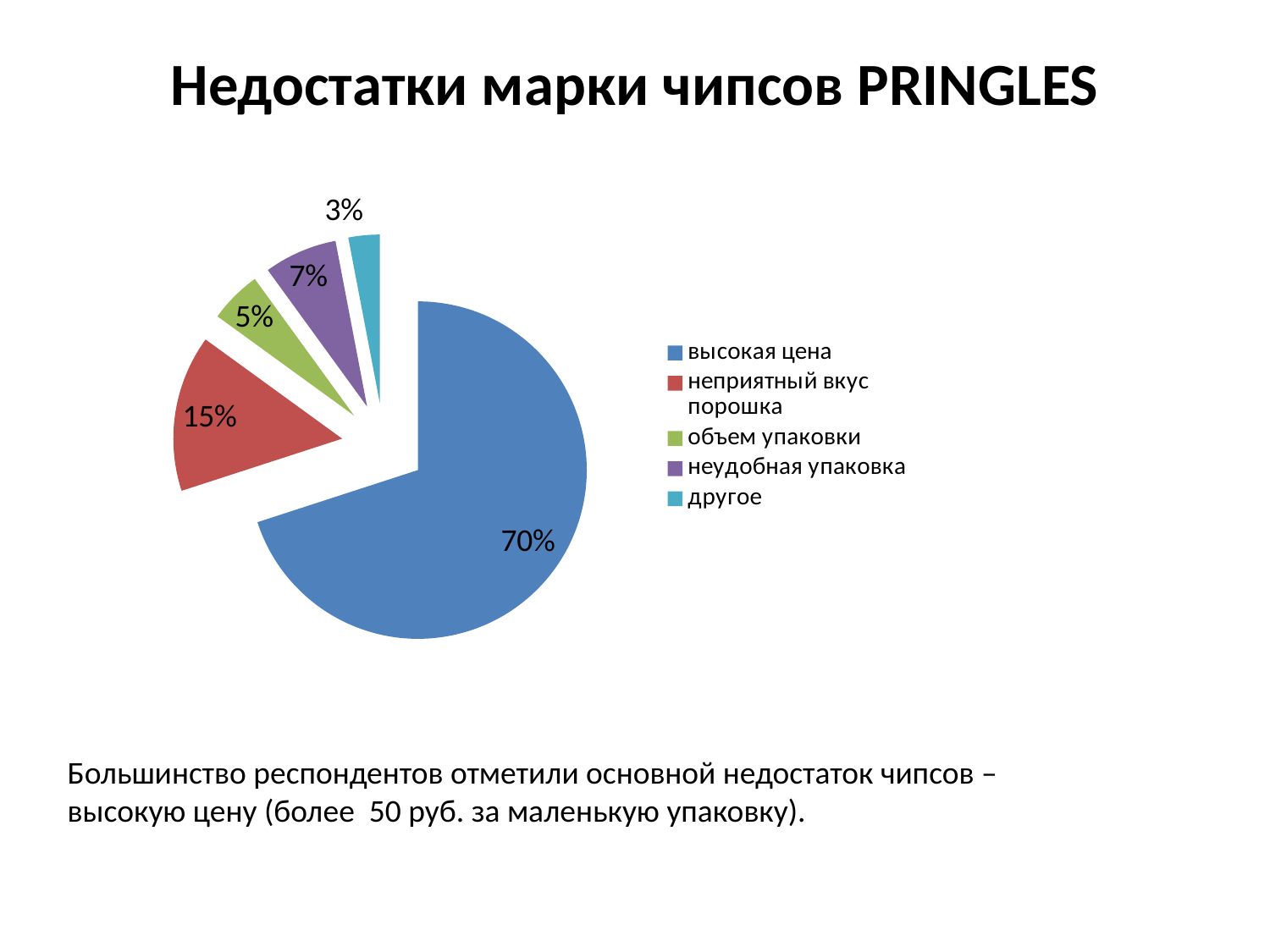
Which is larger: the share for "неудобная упаковка" or the share for "объем упаковки"? неудобная упаковка What share of the pie does "высокая цена" have? 70% Which category has the largest slice of the pie? высокая цена What share of the pie does "объем упаковки" have? 5% What type of chart is shown on the slide? pie chart What share of the pie does "неприятный вкус порошка" have? 15% What is the title of the slide containing the chart? Недостатки марки чипсов PRINGLES How many categories does the pie chart have? 5 What is the difference between the shares of "высокая цена" and "неприятный вкус порошка"? 55% Which category has the smallest slice of the pie? другое